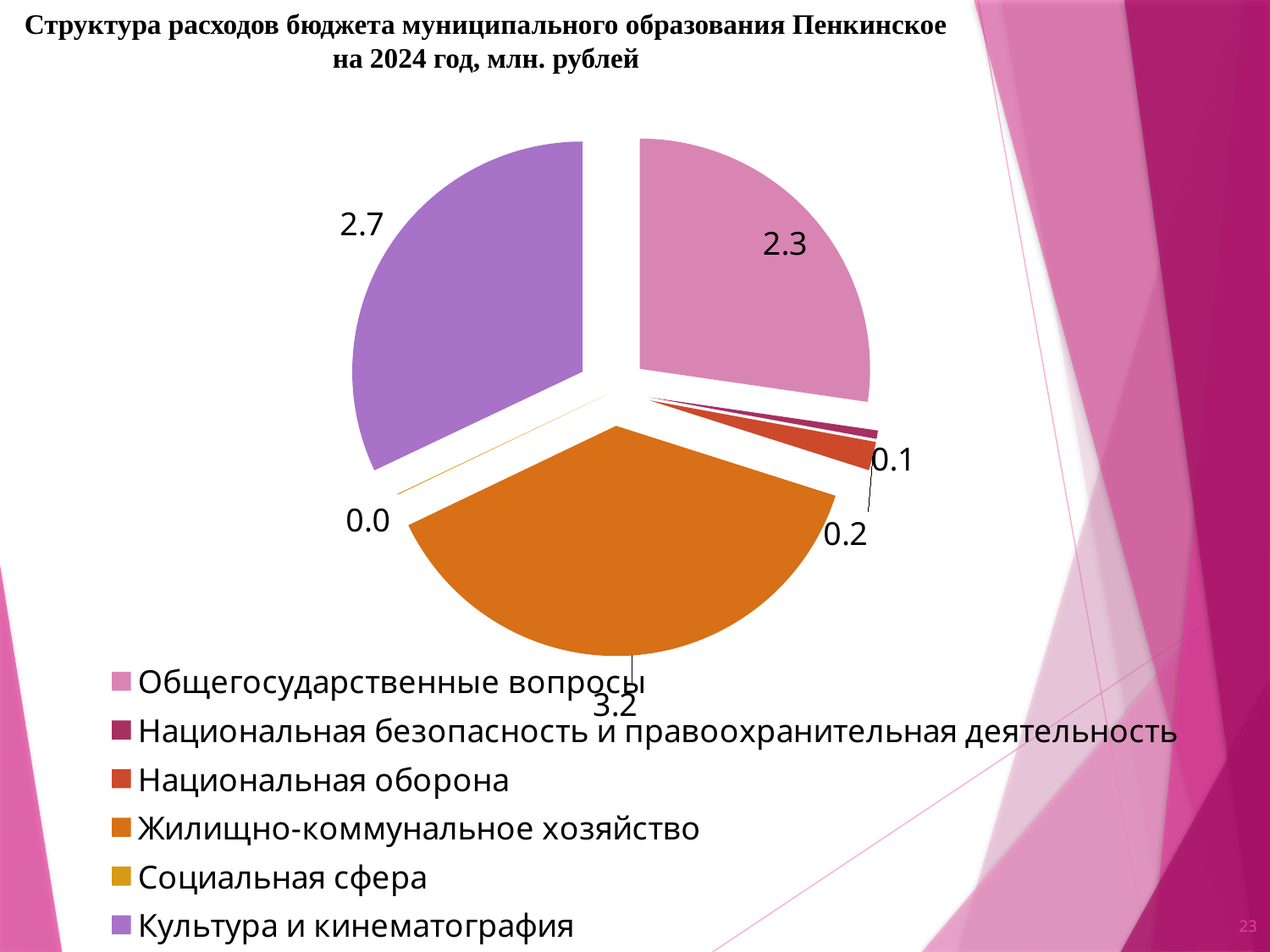
Which category has the largest share of the pie? Жилищно-коммунальное хозяйство What is the value for Культура и кинематография? 2.7 What is the value for Национальная оборона? 0.2 What unit of measurement is stated in the chart title? млн. рублей What is the value for Жилищно-коммунальное хозяйство? 3.2 What is the value for Общегосударственные вопросы? 2.3 How many categories does the legend list? 6 What type of chart is shown on the slide? Pie chart Which category has the smallest value? Социальная сфера What is the value for Социальная сфера? 0.0 What is the difference between the values for Жилищно-коммунальное хозяйство and Общегосударственные вопросы? 0.9 Which is larger: Культура и кинематография or Общегосударственные вопросы? Культура и кинематография